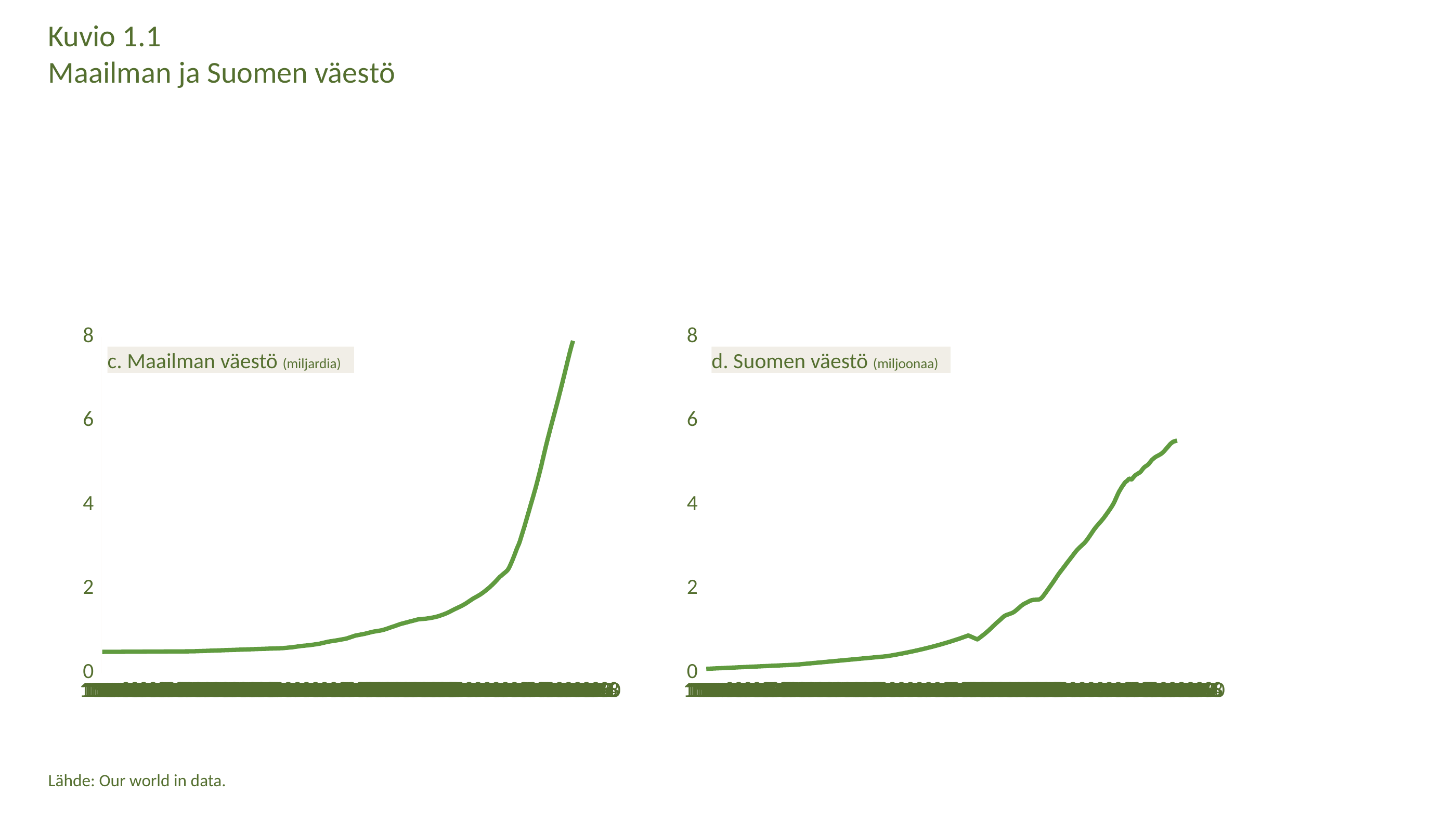
In the right chart "d. Suomen väestö", do the values rise or fall along the x axis? rise What unit is given in the title of the right chart "d. Suomen väestö"? miljoonaa In the right chart "d. Suomen väestö", is the value at the right end of the line greater or less than 6? less What kind of chart is the right chart, "d. Suomen väestö"? line chart In the right chart "d. Suomen väestö", is the value at the left end of the line greater or less than 2? less In the left chart "c. Maailman väestö", is the value at the right end of the line greater or less than 6? greater In the left chart "c. Maailman väestö", do the values rise or fall along the x axis? rise What unit is given in the title of the left chart "c. Maailman väestö"? miljardia What kind of chart is the left chart, "c. Maailman väestö"? line chart